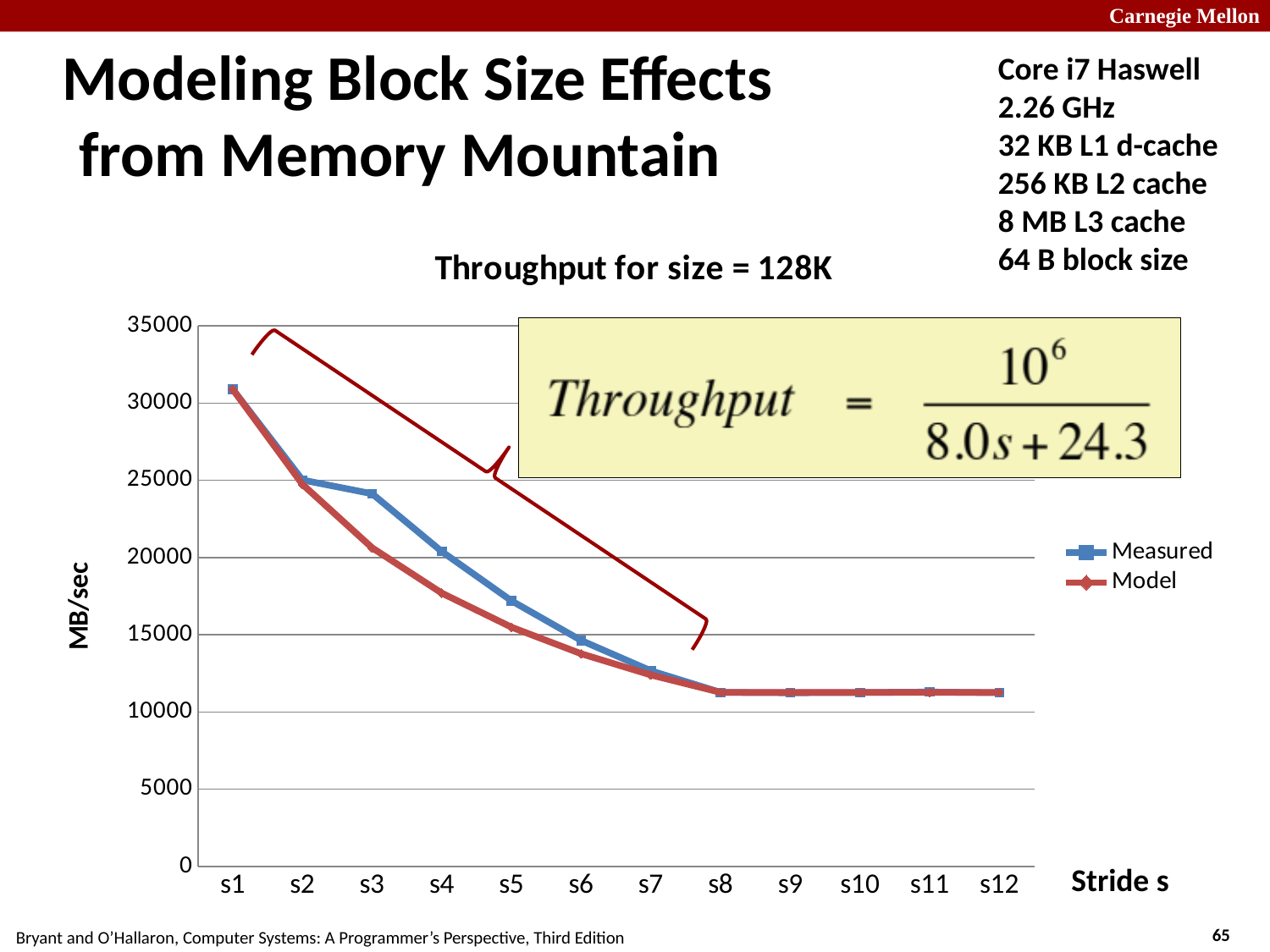
What kind of chart is shown on the slide? line chart Is the Measured value at s1 greater or less than 30000? greater How many stride categories are plotted along the x axis? 12 Is the Model value at s6 greater or less than 15000? less What is the title of the chart? Throughput for size = 128K Is the Measured value at s3 greater or less than 20000? greater Do the Measured values rise or fall as the stride increases from s1 to s8? fall At which stride is the Measured throughput highest? s1 What is the label on the y axis of the chart? MB/sec How many series does the chart's legend list? 2 At stride s3, which series has the larger value, Measured or Model? Measured